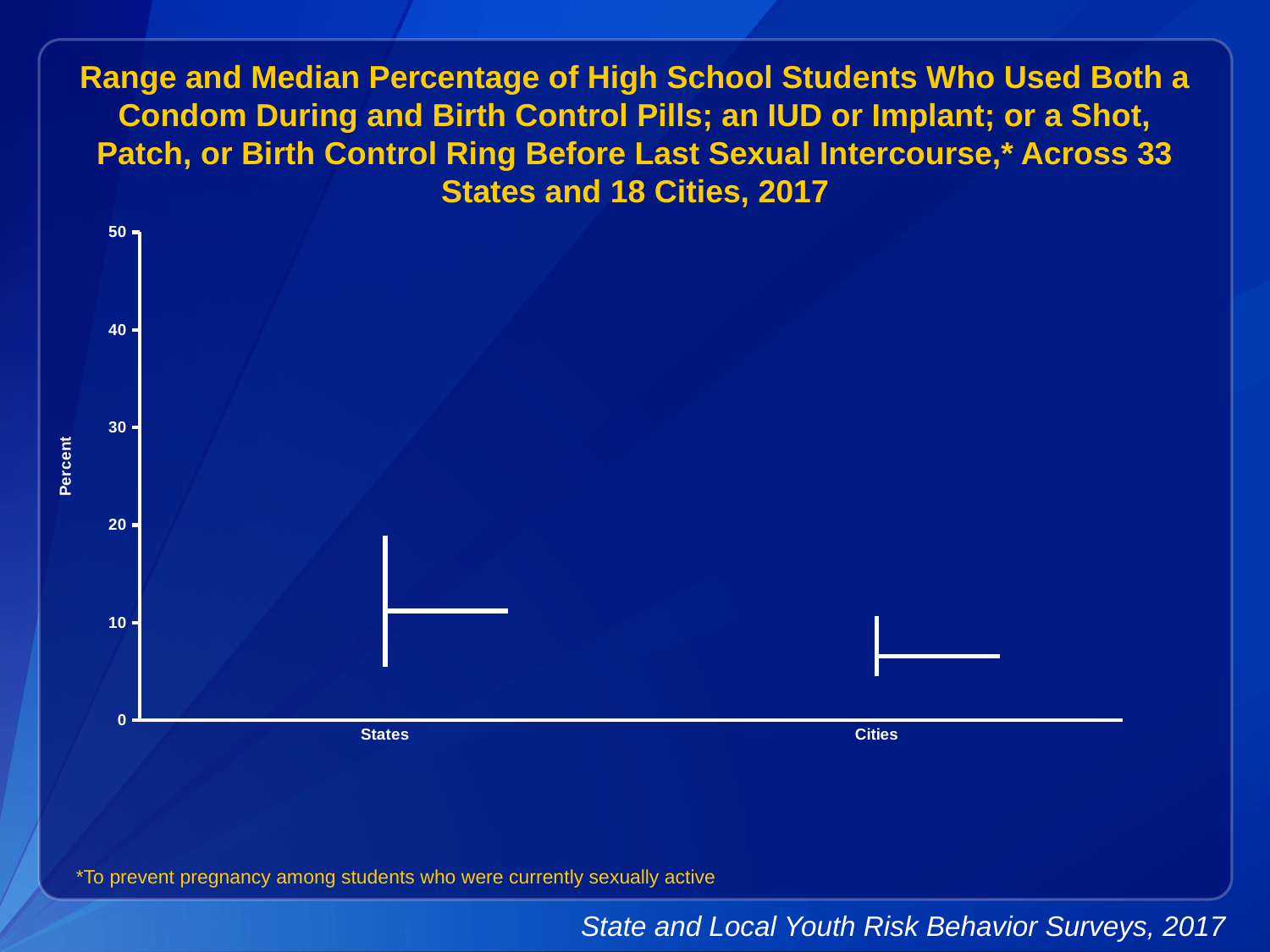
What is the maximum value shown on the y axis? 50 What is the label of the y axis? Percent How many categories are shown on the x axis of the chart? 2 Which category has the lower median percentage? Cities Which category has the higher median percentage, States or Cities? States Is the top of the range for States greater or less than 10? greater Which category shows the wider range of percentages? States Is the bottom of the range for Cities greater or less than 10? less Is the top of the range for States greater or less than 20? less